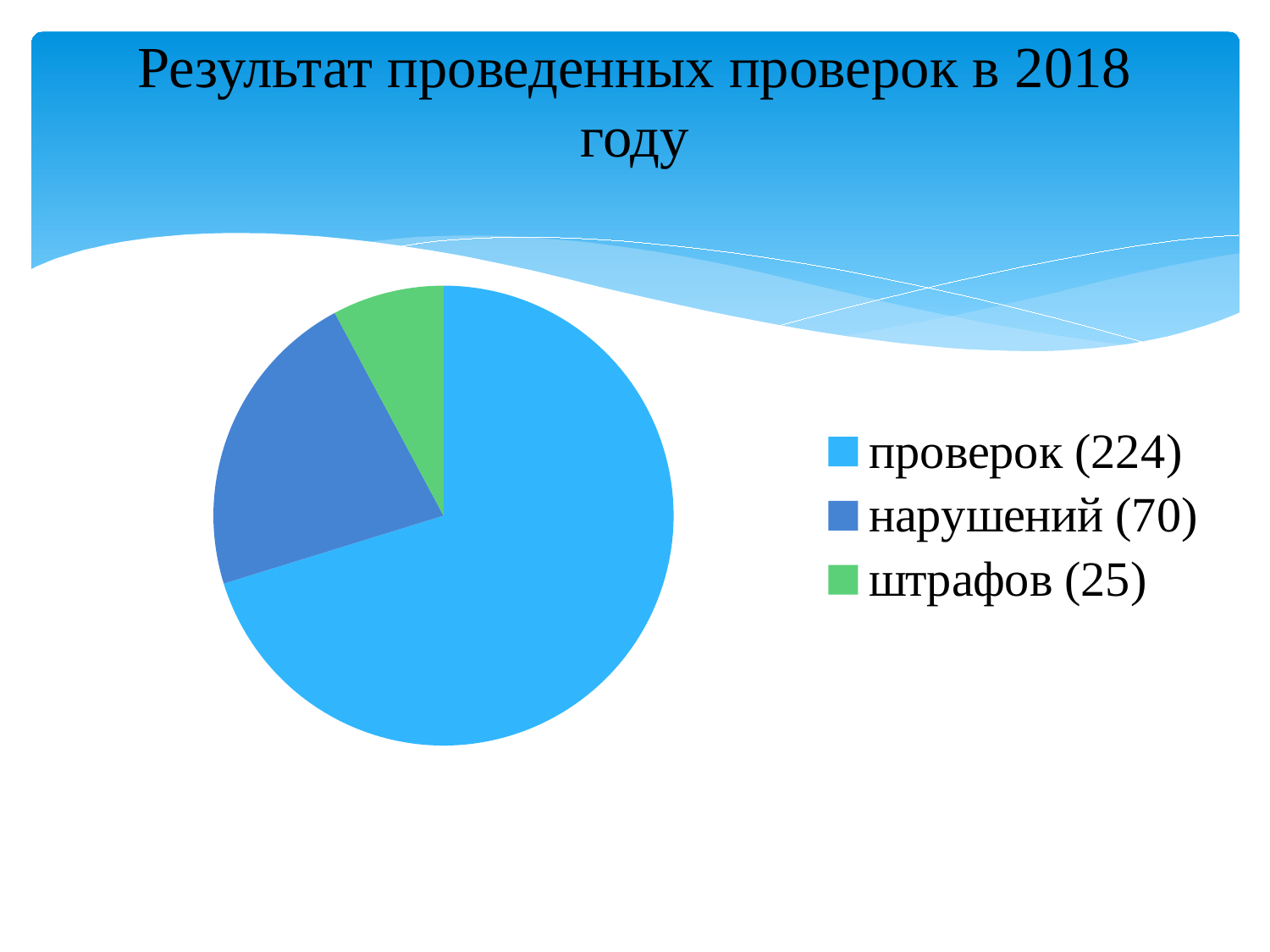
What is the difference between the value for проверок and the value for нарушений? 154 Which category has the smallest slice of the pie? штрафов (25) What kind of chart is shown on the slide? pie chart What value is shown for штрафов in the legend? 25 How many slices does the pie chart have? 3 What value is shown for нарушений in the legend? 70 What is the title of the slide? Результат проведенных проверок в 2018 году Which category has the largest slice of the pie? проверок (224) What value is shown for проверок in the legend? 224 How many entries does the legend list? 3 What is the difference between the value for нарушений and the value for штрафов? 45 Which is larger, the value for нарушений or the value for штрафов? нарушений